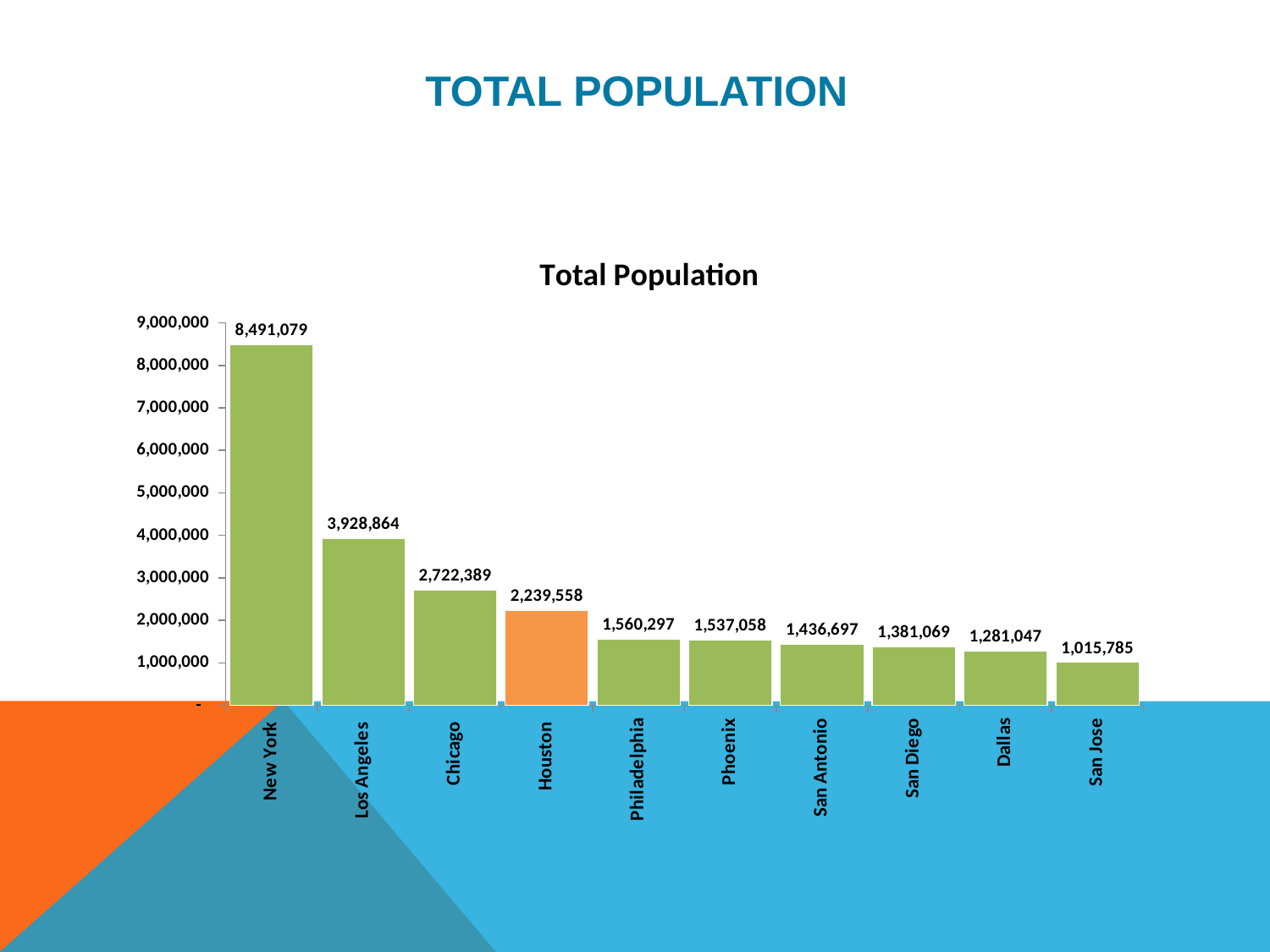
Is the value for Dallas greater or less than 2,000,000? less What is the difference in total population between Chicago and Houston? 482,831 What is the total population shown for San Jose? 1,015,785 Which city has the highest total population in the chart? New York What kind of chart is shown on the slide? Bar chart Which city's bar is coloured orange instead of green? Houston What is the total population shown for Houston? 2,239,558 Which city has the lowest total population in the chart? San Jose What is the total population shown for New York? 8,491,079 Which city has a larger total population, Los Angeles or Chicago? Los Angeles What is the difference in total population between New York and Los Angeles? 4,562,215 How many cities are shown in the chart? 10